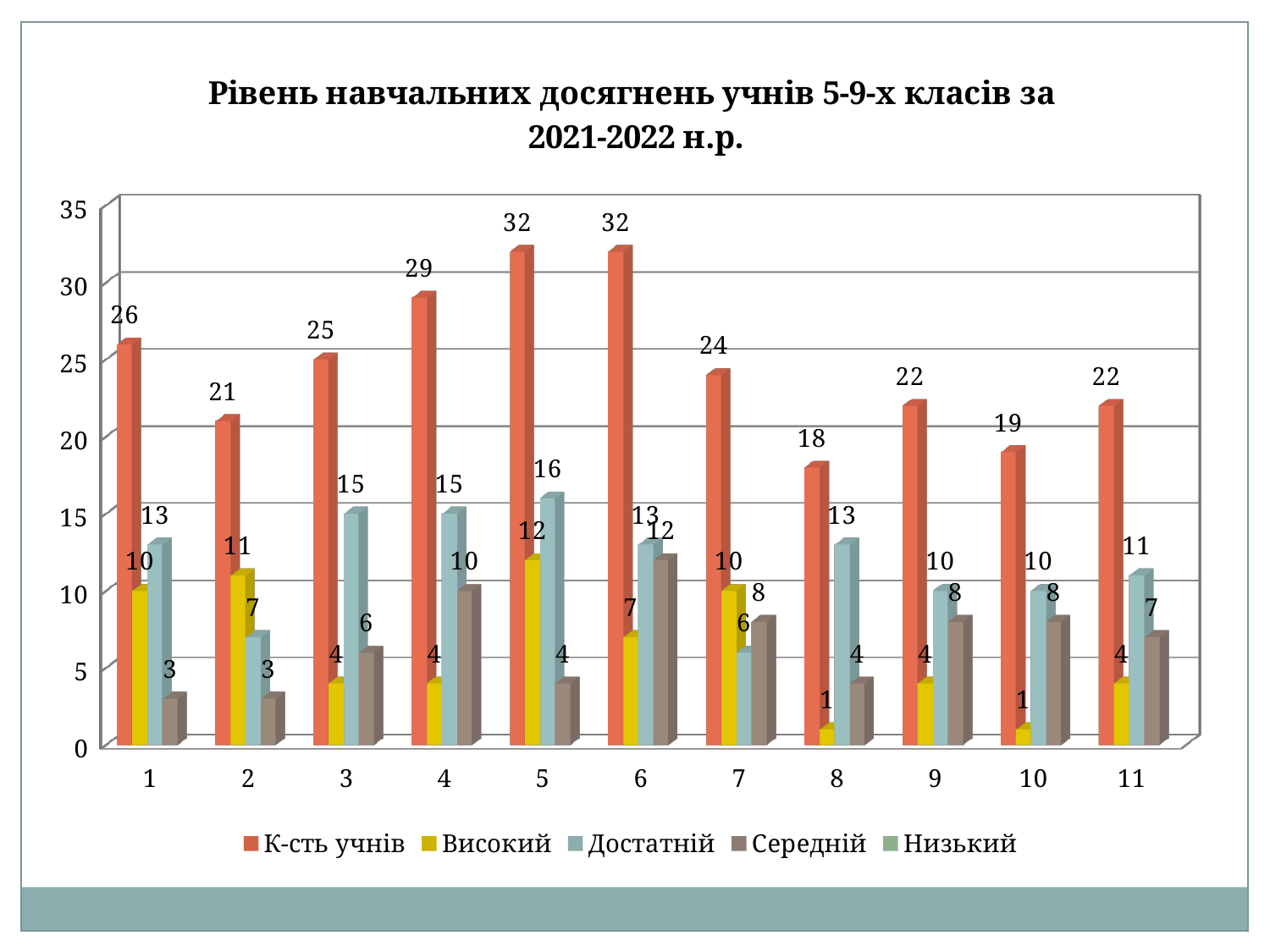
Which is larger: Високий for category 2 or Високий for category 7? Високий for category 2 What kind of chart is shown on the slide? Bar chart What is the value of К-сть учнів for category 4? 29 What is the value of Високий for category 5? 12 What is the title of the chart? Рівень навчальних досягнень учнів 5-9-х класів за 2021-2022 н.р. What is the difference between К-сть учнів for category 5 and category 8? 14 How many categories are shown on the x axis? 11 How many series does the legend list? 5 Which category has the lowest value for К-сть учнів? 8 Which category has the highest value for Достатній? 5 What is the value of Середній for category 6? 12 What is the value of Достатній for category 8? 13